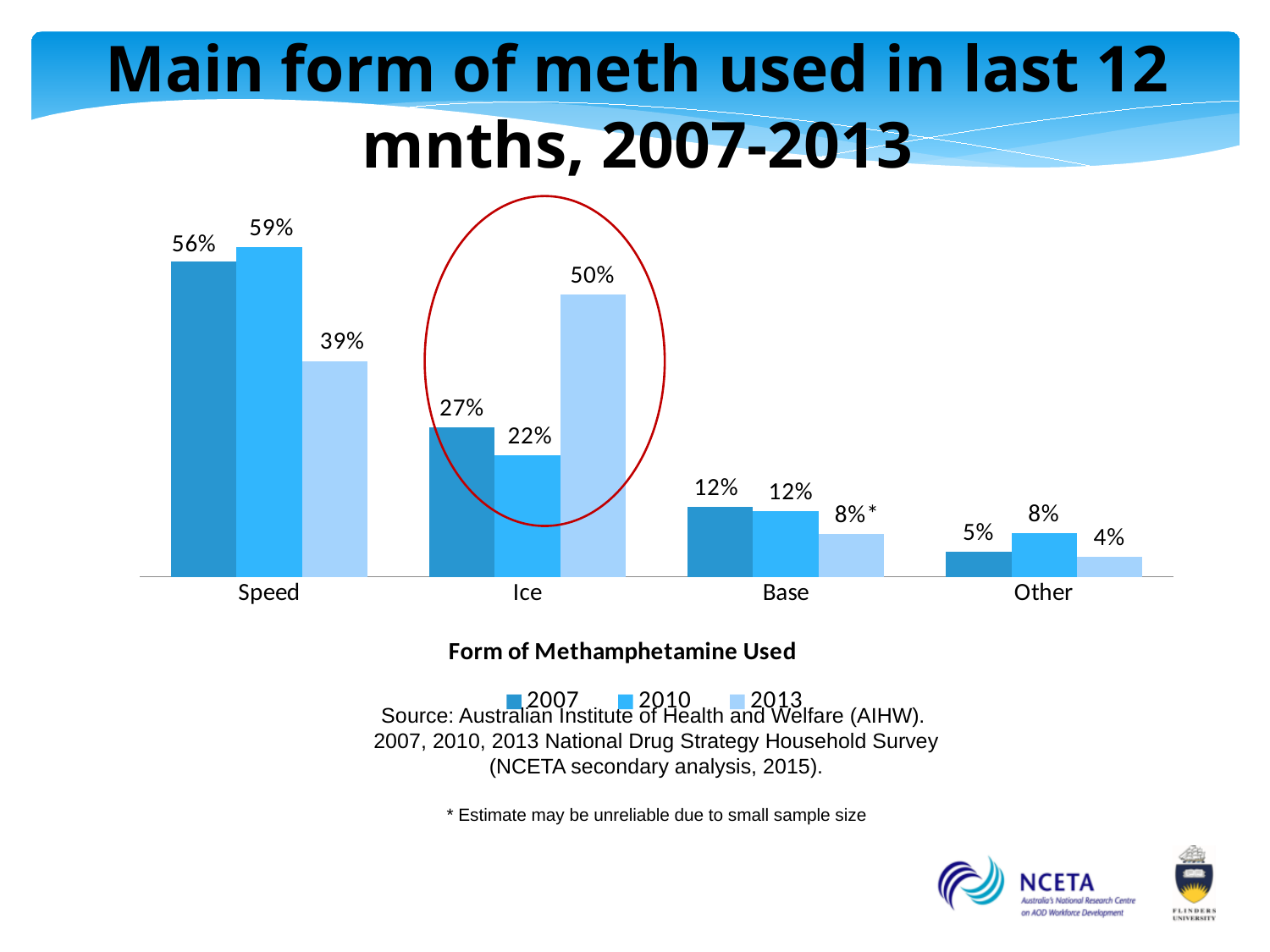
What percentage of users reported Ice as their main form of meth in 2013? 50% What was the value for Other in 2013? 4% How many forms of methamphetamine are shown on the x axis? 4 Which form of methamphetamine had the highest value in 2010? Speed What was the value for Base in 2010? 12% Which is larger: the value for Speed in 2013 or the value for Ice in 2013? Ice in 2013 How many series does the legend list? 3 Which form of methamphetamine had the lowest value in 2007? Other Which category on the chart is circled in red? Ice By how many percentage points did the value for Ice change from 2010 to 2013? 28 percentage points What was the value for Speed in 2007? 56% What kind of chart is shown on the slide? Bar chart